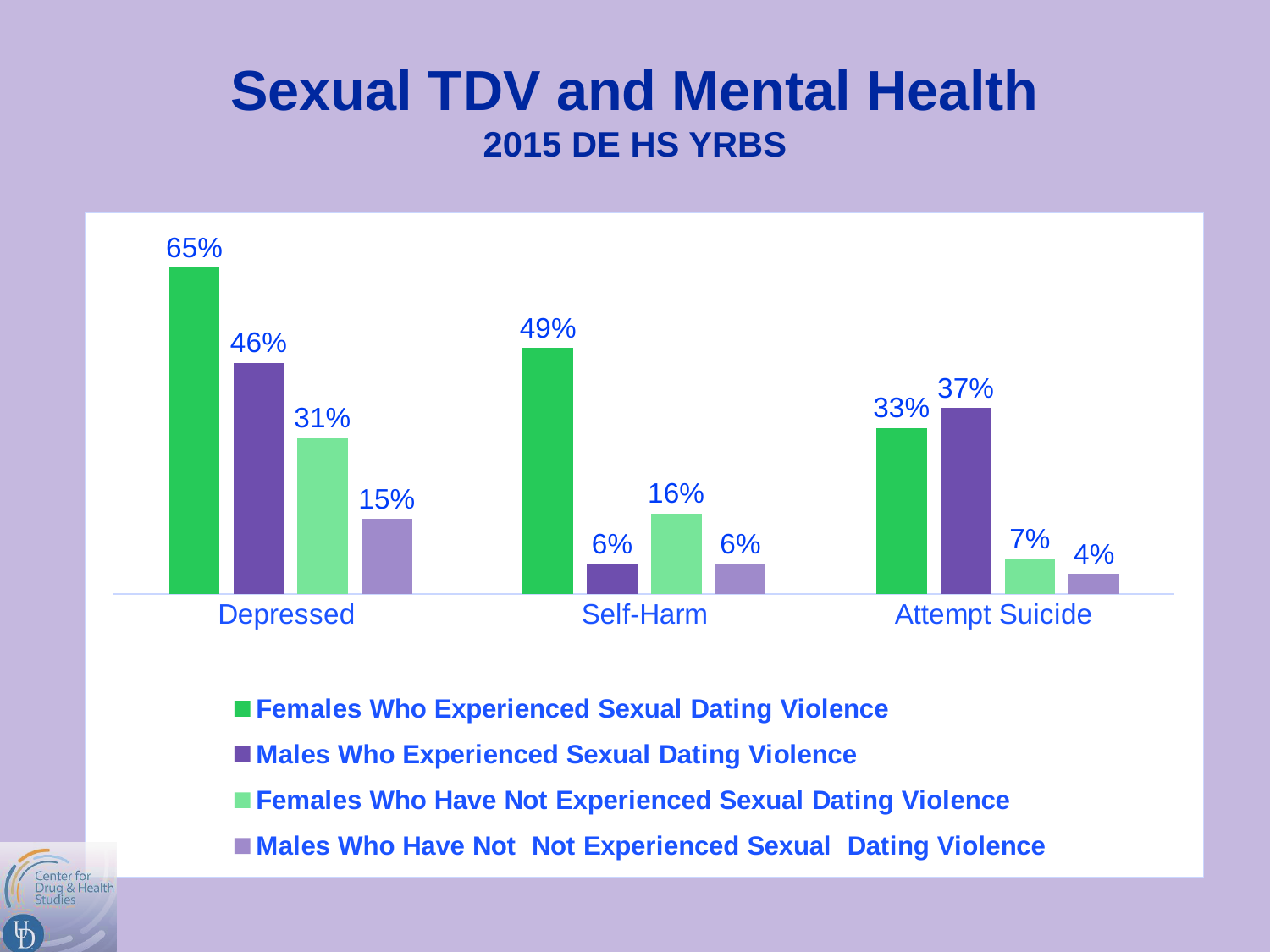
What kind of chart is shown on the slide? Bar chart What is the difference between Males Who Experienced Sexual Dating Violence in the Depressed category and in the Self-Harm category? 40% In the Attempt Suicide category, which is larger: Females Who Experienced Sexual Dating Violence or Males Who Experienced Sexual Dating Violence? Males Who Experienced Sexual Dating Violence What is the value for Females Who Experienced Sexual Dating Violence in the Depressed category? 65% Which category has the highest value for Females Who Experienced Sexual Dating Violence? Depressed What is the value for Females Who Have Not Experienced Sexual Dating Violence in the Self-Harm category? 16% What is the difference between Females Who Experienced Sexual Dating Violence and Females Who Have Not Experienced Sexual Dating Violence in the Depressed category? 34% What is the title of the chart? Sexual TDV and Mental Health 2015 DE HS YRBS Which category has the lowest value for Males Who Have Not Experienced Sexual Dating Violence? Attempt Suicide How many categories are shown on the x axis? 3 What is the value for Males Who Experienced Sexual Dating Violence in the Attempt Suicide category? 37% How many series does the legend list? 4